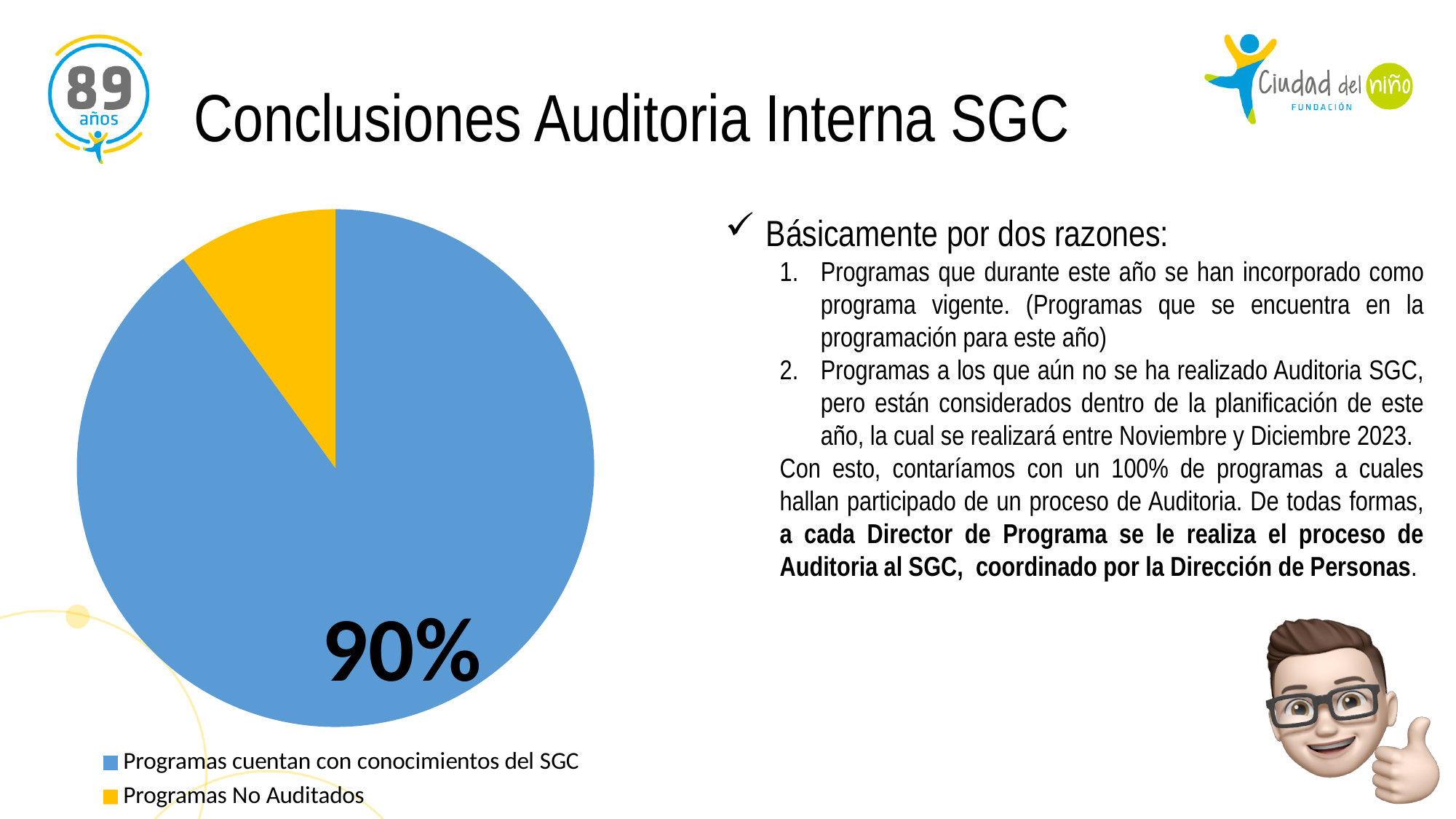
Which slice of the pie chart is the largest? Programas cuentan con conocimientos del SGC Which is larger: the slice for 'Programas cuentan con conocimientos del SGC' or the slice for 'Programas No Auditados'? Programas cuentan con conocimientos del SGC Is the share of the pie for 'Programas cuentan con conocimientos del SGC' greater or less than 50%? greater How many entries does the legend of the pie chart list? 2 What share of the pie does the slice for 'Programas cuentan con conocimientos del SGC' represent? 90% What colour is the slice for 'Programas cuentan con conocimientos del SGC'? blue Which slice of the pie chart is the smallest? Programas No Auditados How many slices does the pie chart have? 2 What type of chart is shown on the slide? pie chart What colour is the slice for 'Programas No Auditados'? yellow Is the share of the pie for 'Programas No Auditados' greater or less than 25%? less